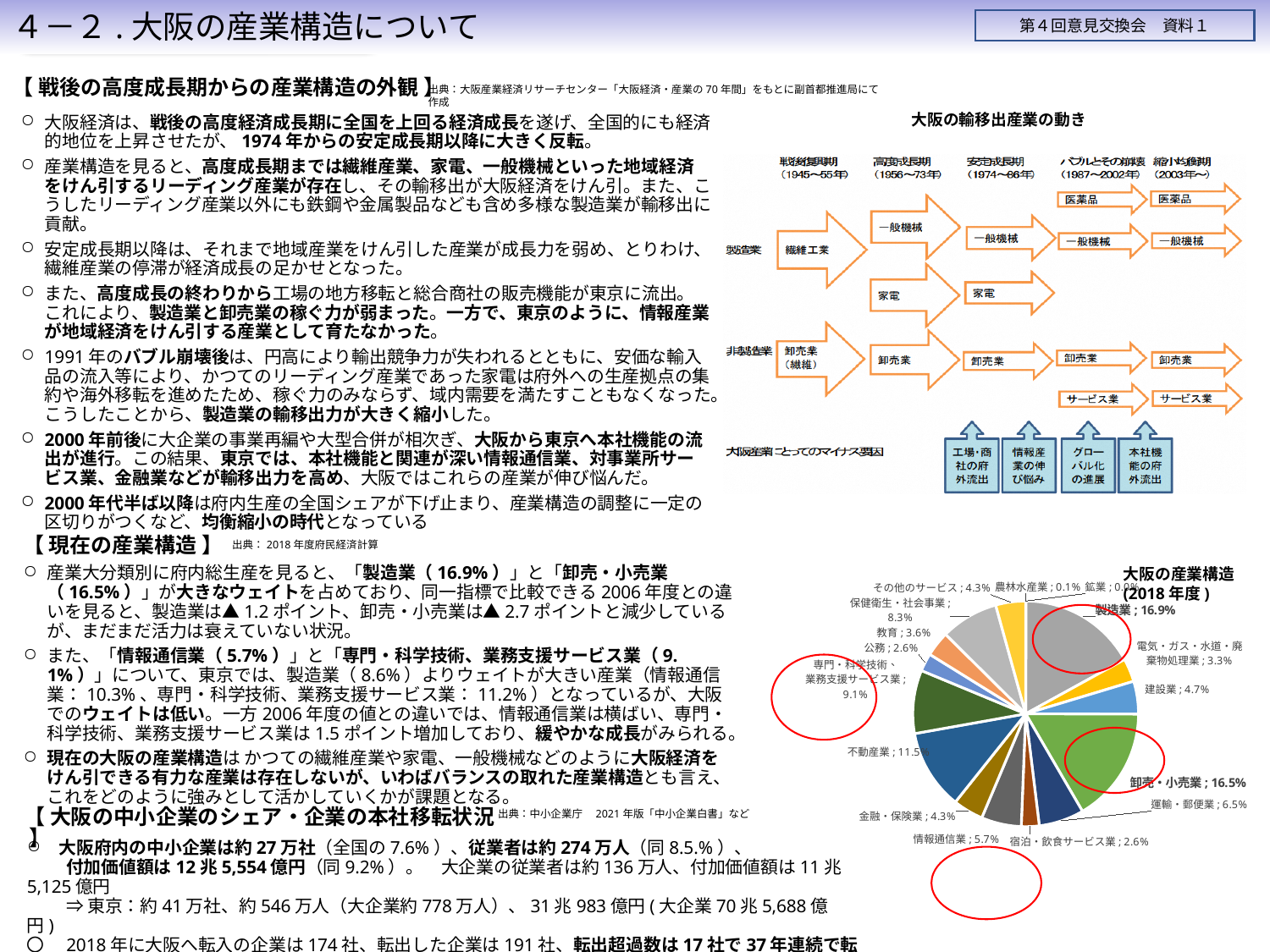
In the pie chart 大阪の産業構造（2018年度）, which has the larger share, 不動産業 or 保健衛生・社会事業? 不動産業 In the pie chart 大阪の産業構造（2018年度）, what share does 卸売・小売業 have? 16.5% In the pie chart 大阪の産業構造（2018年度）, what share does 情報通信業 have? 5.7% What is the title of the pie chart on the slide? 大阪の産業構造（2018年度） How many industry categories are shown in the pie chart 大阪の産業構造（2018年度）? 16 In the pie chart 大阪の産業構造（2018年度）, what is the difference in percentage points between 製造業 and 卸売・小売業? 0.4 percentage points In the pie chart 大阪の産業構造（2018年度）, what share does 不動産業 have? 11.5% In the pie chart 大阪の産業構造（2018年度）, what share does 製造業 have? 16.9% In the pie chart 大阪の産業構造（2018年度）, what share does 専門・科学技術、業務支援サービス業 have? 9.1% In the pie chart 大阪の産業構造（2018年度）, which industry has the largest share? 製造業 What type of chart is shown at the bottom right of the slide? Pie chart In the pie chart 大阪の産業構造（2018年度）, which industry has the smallest share? 鉱業